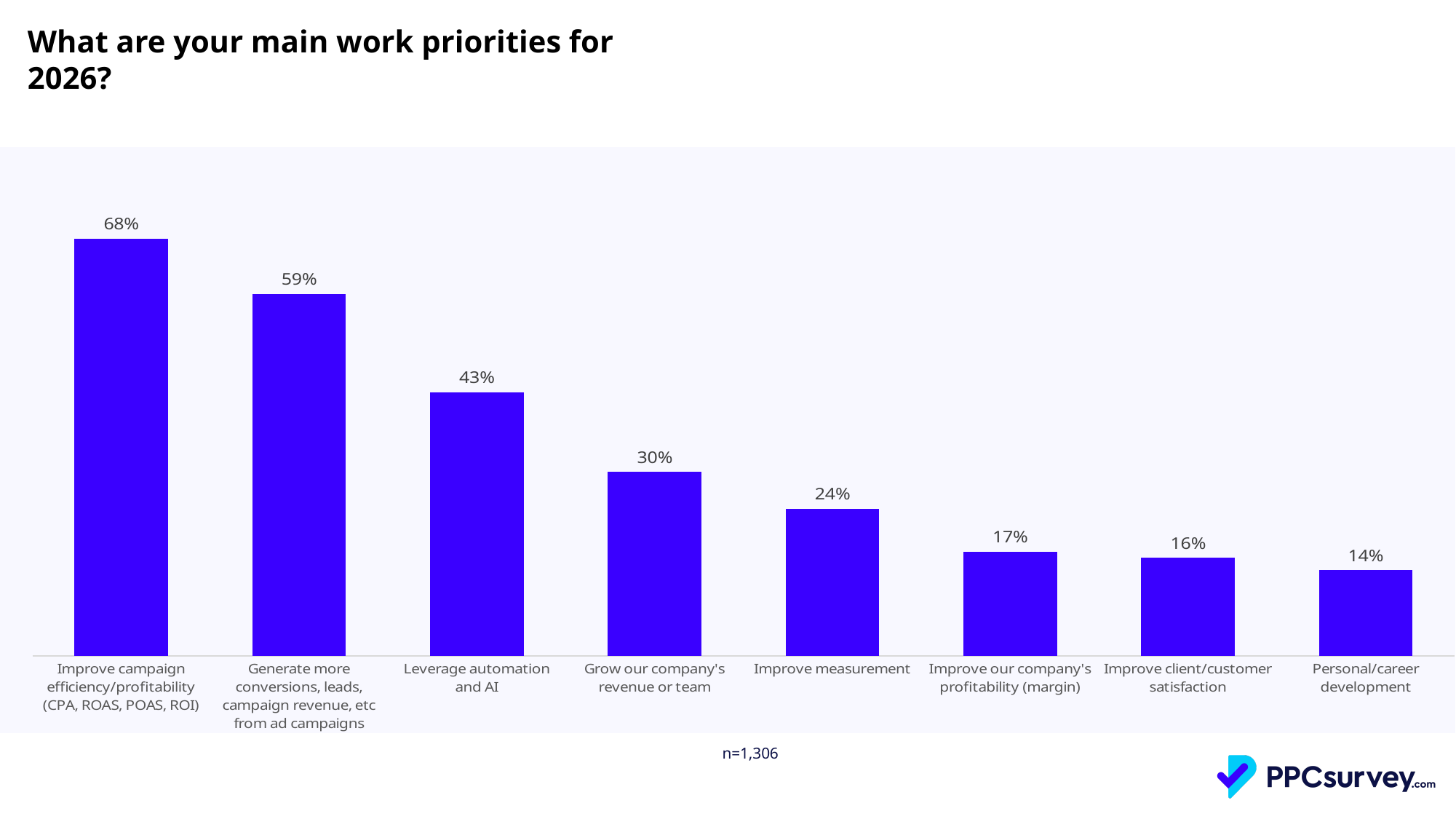
Do the values rise or fall from left to right across the chart? Fall Which work priority has the lowest percentage? Personal/career development What is the sample size (n) noted below the chart? n=1,306 What percentage is shown for 'Personal/career development'? 14% Which is larger: the value for 'Improve our company's profitability (margin)' or the value for 'Improve client/customer satisfaction'? Improve our company's profitability (margin) What is the value shown for 'Improve measurement'? 24% What percentage of respondents chose 'Leverage automation and AI' as a main work priority for 2026? 43% What is the difference in percentage points between 'Improve campaign efficiency/profitability' and 'Generate more conversions, leads, campaign revenue, etc from ad campaigns'? 9 percentage points Which work priority has the highest percentage? Improve campaign efficiency/profitability (CPA, ROAS, POAS, ROI) What type of chart is shown on the slide? Bar chart What is the difference between 'Grow our company's revenue or team' and 'Improve measurement'? 6 percentage points How many work priorities are shown in the chart? 8